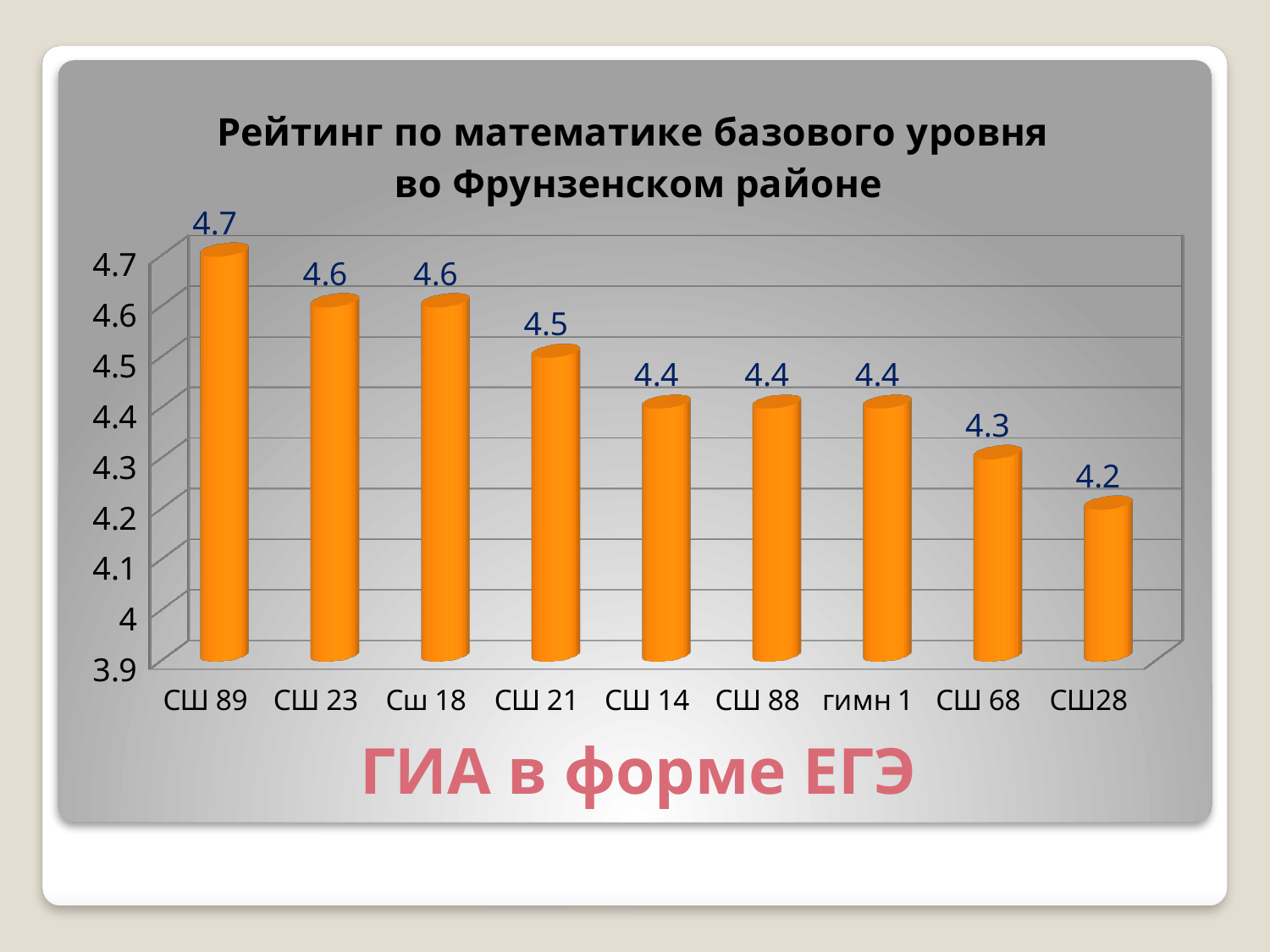
Do the values rise or fall from left to right along the x axis? fall What is the difference between the values for СШ 89 and СШ28? 0.5 What is the value for СШ 89? 4.7 Which is larger, the value for СШ 23 or the value for СШ 14? СШ 23 What is the title of the chart? Рейтинг по математике базового уровня во Фрунзенском районе What kind of chart is this? bar chart How many schools are shown on the chart? 9 What is the value for СШ 68? 4.3 What is the value for СШ 21? 4.5 Which school has the highest rating? СШ 89 What is the value for гимн 1? 4.4 Which school has the lowest rating? СШ28